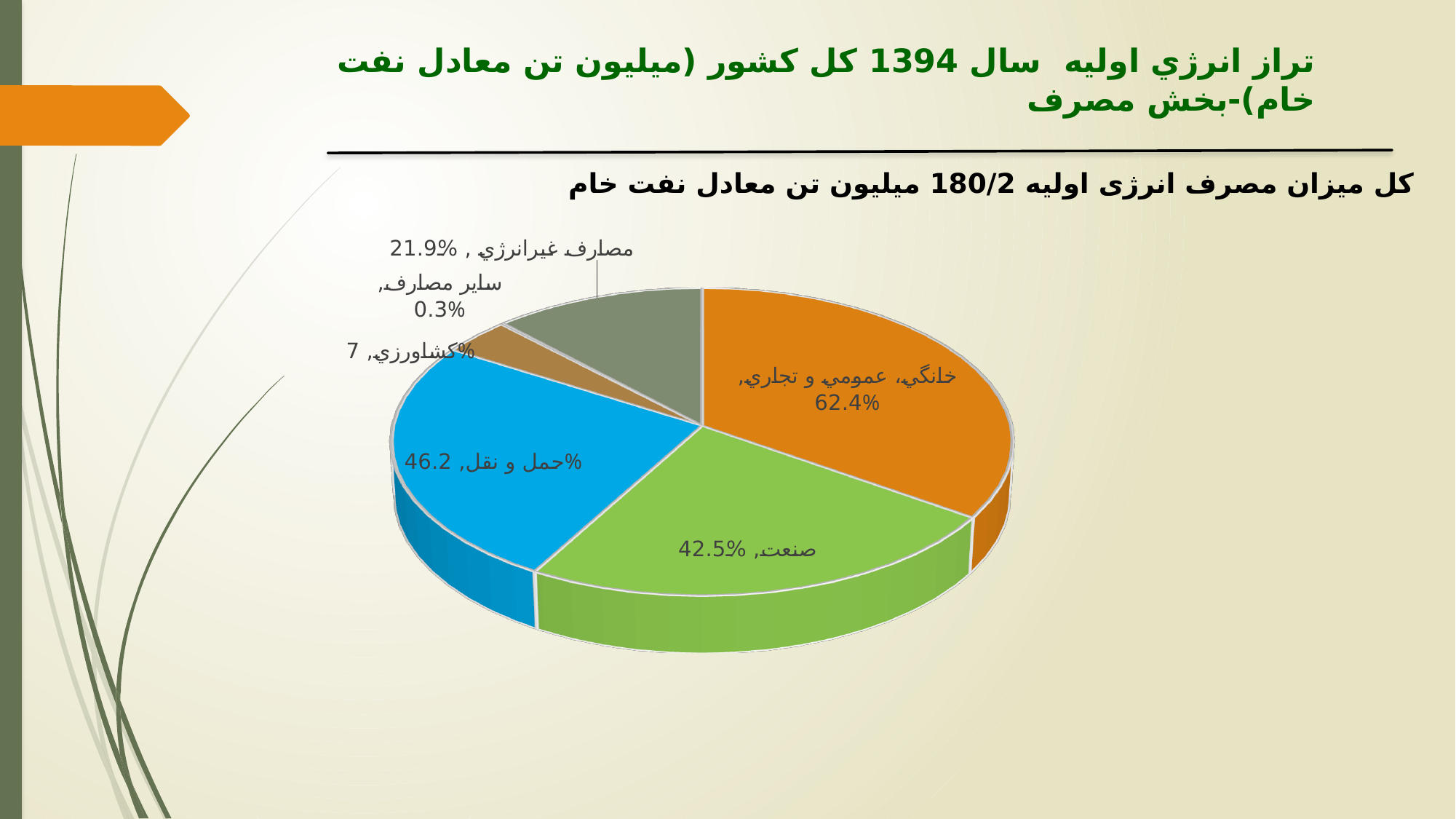
Which is larger, the value for حمل و نقل or the value for صنعت? حمل و نقل What value is shown for the مصارف غيرانرژي slice? 21.9% What value is shown for the ساير مصارف slice? 0.3% Which category has the smallest slice of the pie? ساير مصارف What value is shown for the صنعت slice? 42.5% How many slices does the pie chart have? 6 What is the difference between the values for خانگي، عمومي و تجاري and حمل و نقل? 16.2% What value is shown for the حمل و نقل slice? 46.2% Which category has the largest slice of the pie? خانگي، عمومي و تجاري According to the text above the chart, what is the total primary energy consumption in million tonnes of crude oil equivalent? 180/2 What type of chart is shown on the slide? pie chart What value is shown for the خانگي، عمومي و تجاري slice? 62.4%